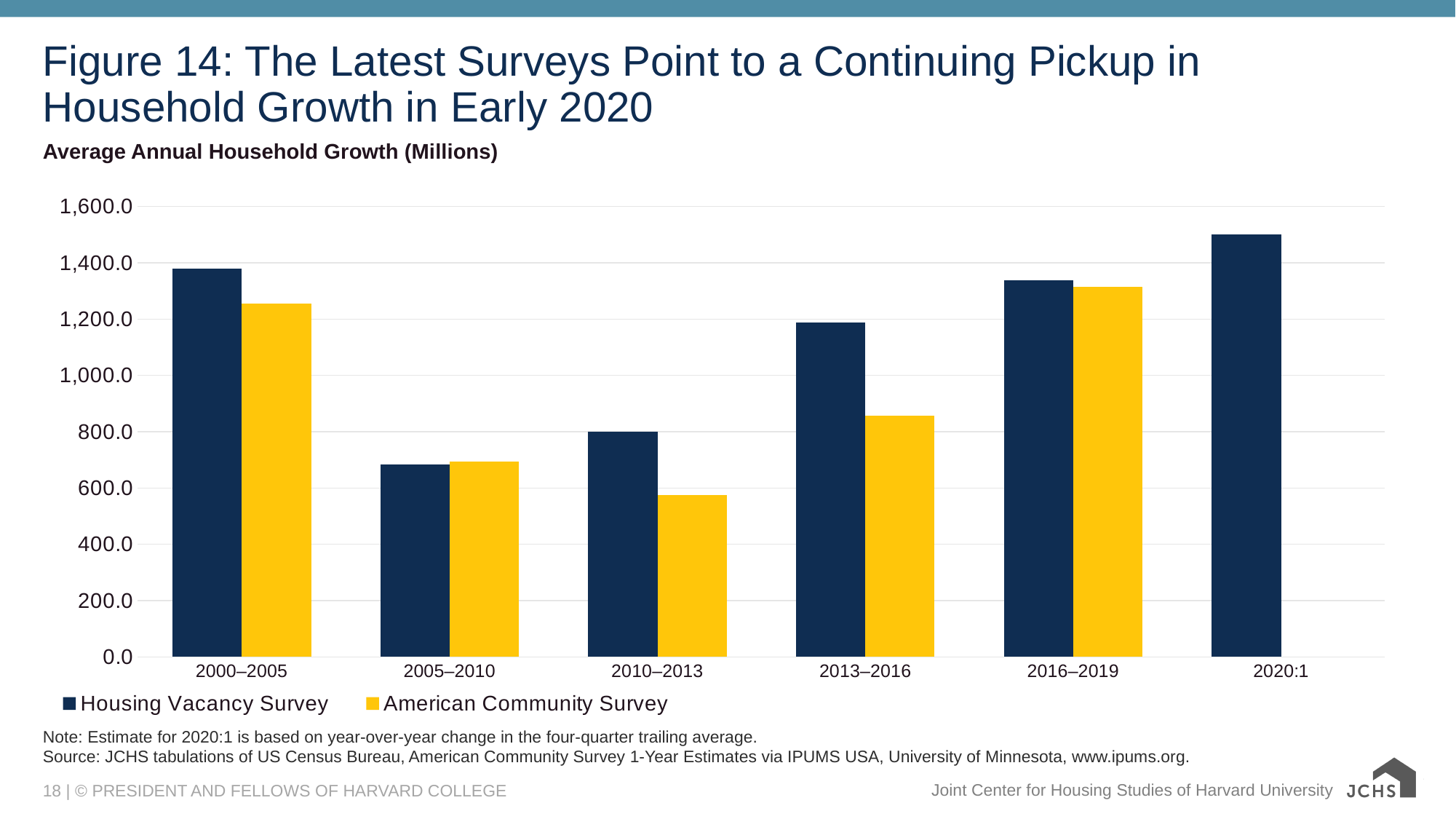
For 2013–2016, which is larger: the Housing Vacancy Survey value or the American Community Survey value? Housing Vacancy Survey Which period has the highest American Community Survey value? 2016–2019 How many period categories are shown on the x axis? 6 Is the American Community Survey value for 2010–2013 greater or less than 600.0? less Which period has the lowest American Community Survey value? 2010–2013 Which period has the highest Housing Vacancy Survey value? 2020:1 Which period has the lowest Housing Vacancy Survey value? 2005–2010 Is the Housing Vacancy Survey value for 2020:1 greater or less than 1,400.0? greater How many series does the legend list? 2 Is the American Community Survey value for 2013–2016 greater or less than 800.0? greater Which series is shown in yellow? American Community Survey What kind of chart is shown on the slide? Bar chart